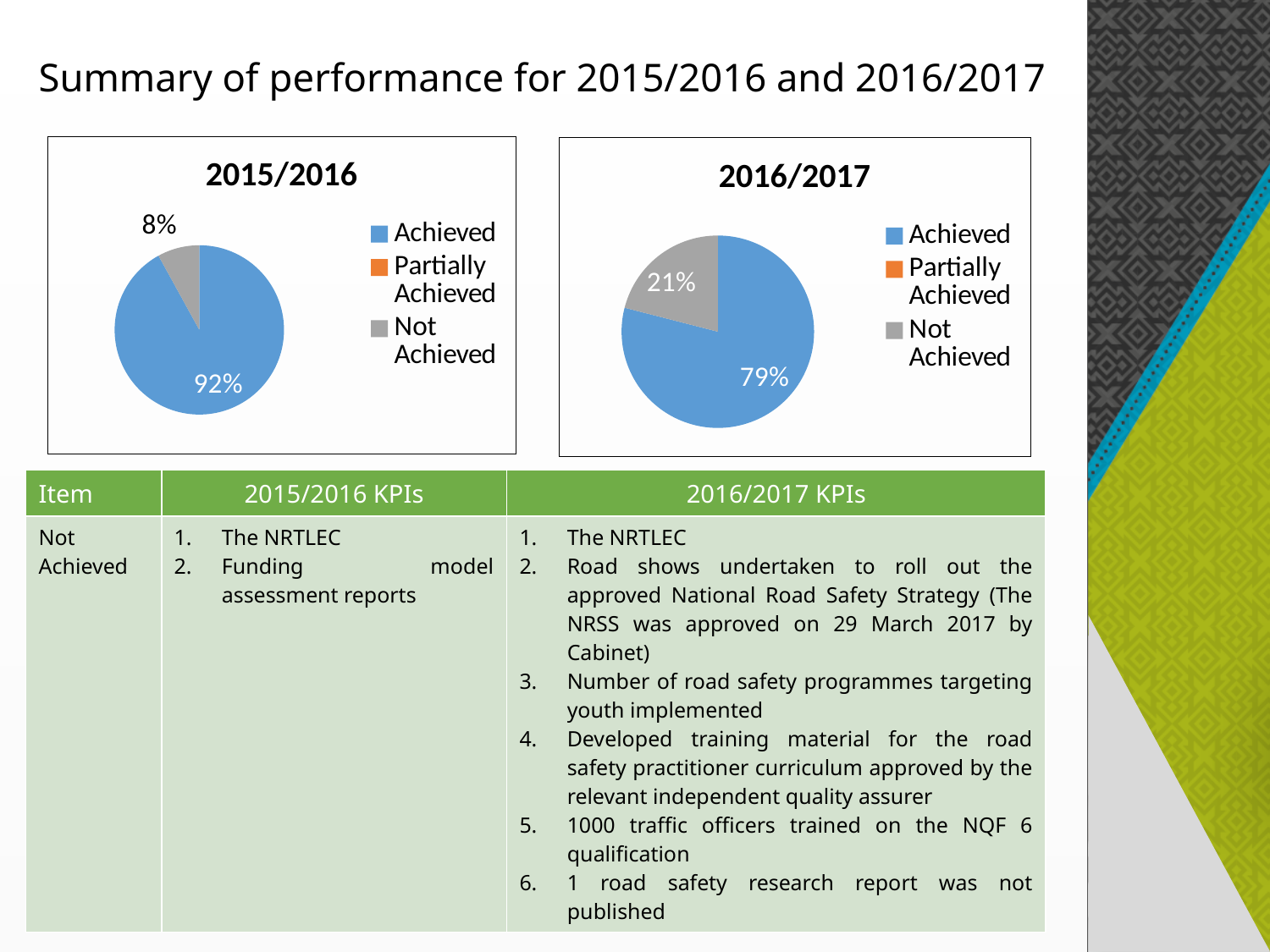
In the 2015/2016 chart, what percentage is shown for Not Achieved? 8% What is the title of the chart on the right? 2016/2017 In the 2016/2017 chart, which category has the largest slice? Achieved In the 2016/2017 chart, what percentage is shown for Not Achieved? 21% In the 2016/2017 chart, what percentage is shown for Achieved? 79% In the 2015/2016 chart, what colour is the Achieved slice? Blue What is the difference between the Achieved percentage in the 2015/2016 chart and the Achieved percentage in the 2016/2017 chart? 13% In the 2015/2016 chart, which labelled category has the smallest slice? Not Achieved What type of chart is used for 2015/2016 and 2016/2017? Pie chart Which chart shows a larger Not Achieved share, 2015/2016 or 2016/2017? 2016/2017 How many entries does the legend of the 2016/2017 chart list? 3 In the 2015/2016 chart, what percentage is shown for Achieved? 92%